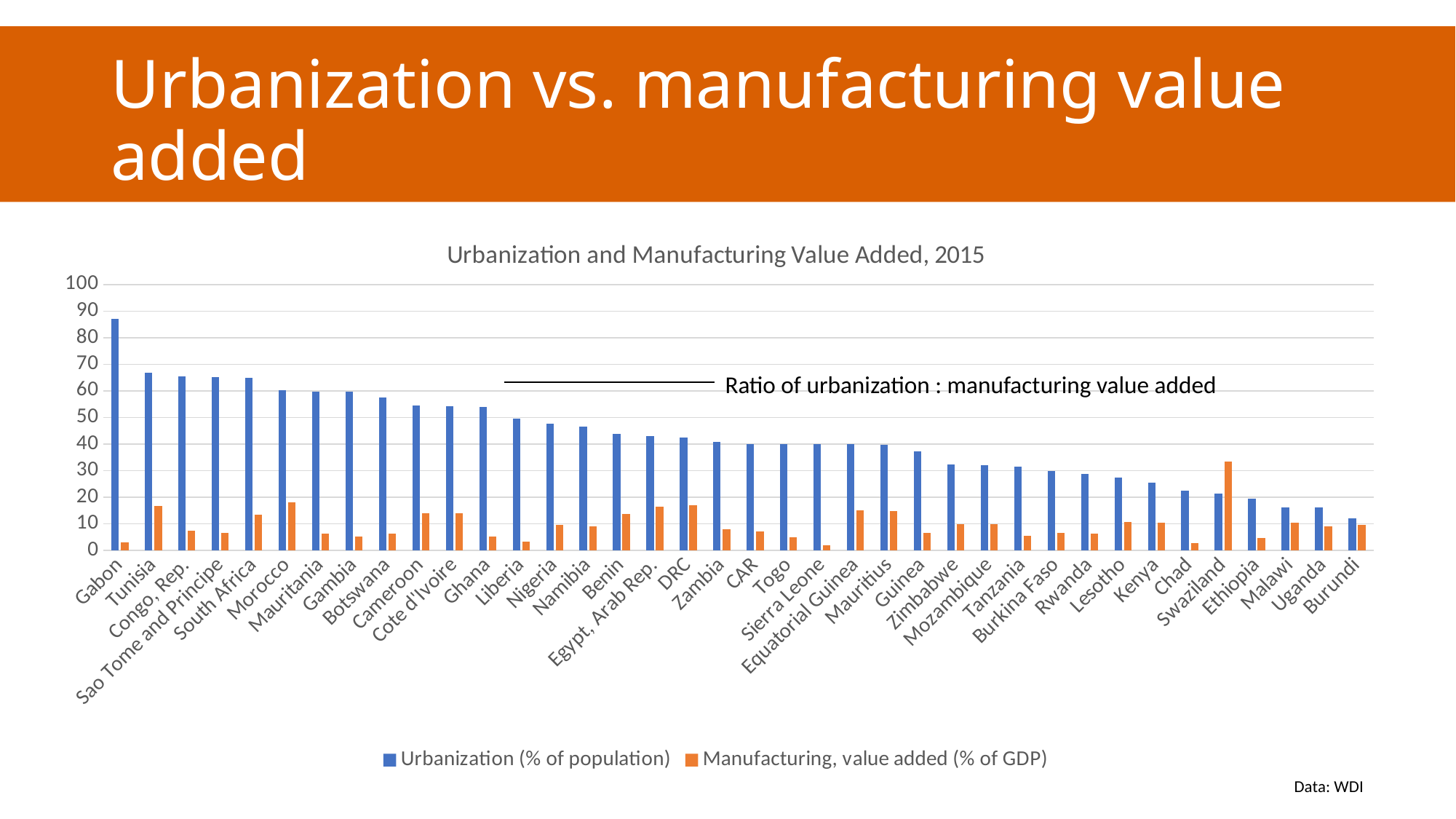
Which country has the highest Urbanization (% of population)? Gabon Which country has the lowest Urbanization (% of population)? Burundi How many countries are shown on the x axis? 38 What is the title of the chart? Urbanization and Manufacturing Value Added, 2015 Is the Urbanization value for Gabon greater or less than 80? greater Is the Manufacturing, value added value for Swaziland greater or less than 30? greater Do the Urbanization values rise or fall moving from left to right along the x axis? fall How many series does the legend list? 2 What type of chart is shown on the slide? bar chart For Swaziland, which is larger: Urbanization (% of population) or Manufacturing, value added (% of GDP)? Manufacturing, value added (% of GDP) Which country has the highest Manufacturing, value added (% of GDP)? Swaziland